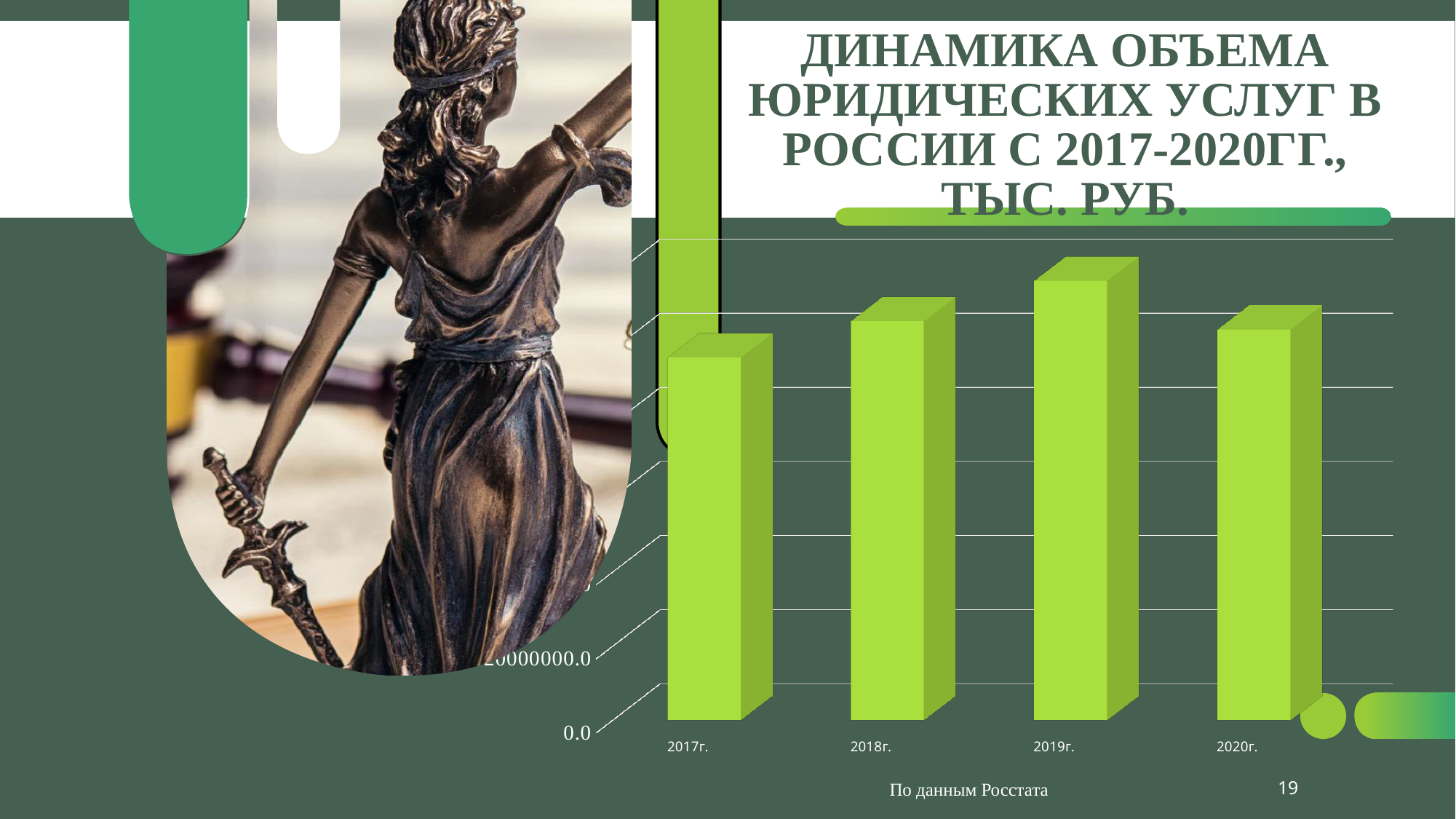
What data source is cited below the chart? По данным Росстата Do the values rise or fall from 2019г. to 2020г.? fall What is the title of the chart on the slide? ДИНАМИКА ОБЪЕМА ЮРИДИЧЕСКИХ УСЛУГ В РОССИИ С 2017-2020ГГ., ТЫС. РУБ. Which year has the lowest bar in the chart? 2017г. Which is larger, the value for 2017г. or the value for 2018г.? 2018г. Is the value for 2020г. greater or less than 20000000.0? greater Is the value for 2017г. greater or less than 20000000.0? greater Do the values rise or fall from 2017г. to 2019г.? rise How many years (categories) are plotted in the chart? 4 Which is larger, the value for 2017г. or the value for 2019г.? 2019г. Which year has the highest bar in the chart? 2019г. What kind of chart is shown on the slide? bar chart